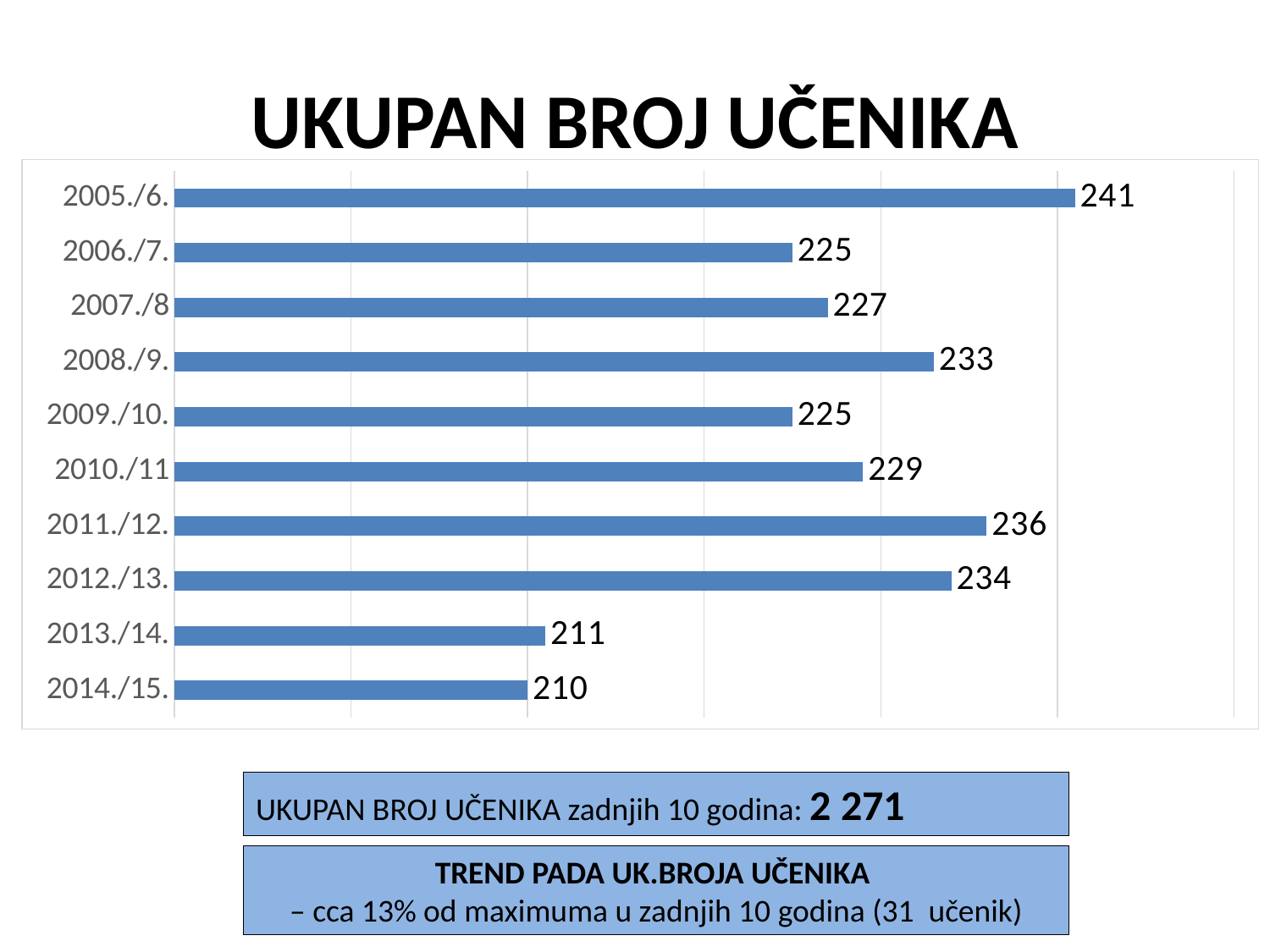
What is the title of the slide? UKUPAN BROJ UČENIKA What is the value for 2008./9.? 233 How many school years are shown in the chart? 10 Which is larger, the value for 2007./8 or the value for 2010./11? 2010./11 What is the value for 2014./15.? 210 What is the difference between the values for 2005./6. and 2014./15.? 31 Which school year has the lowest number of students? 2014./15. What is the value for 2005./6.? 241 What is the value for 2011./12.? 236 Which school year has the highest number of students? 2005./6. What is the difference between the values for 2012./13. and 2013./14.? 23 What kind of chart is shown on the slide? Bar chart